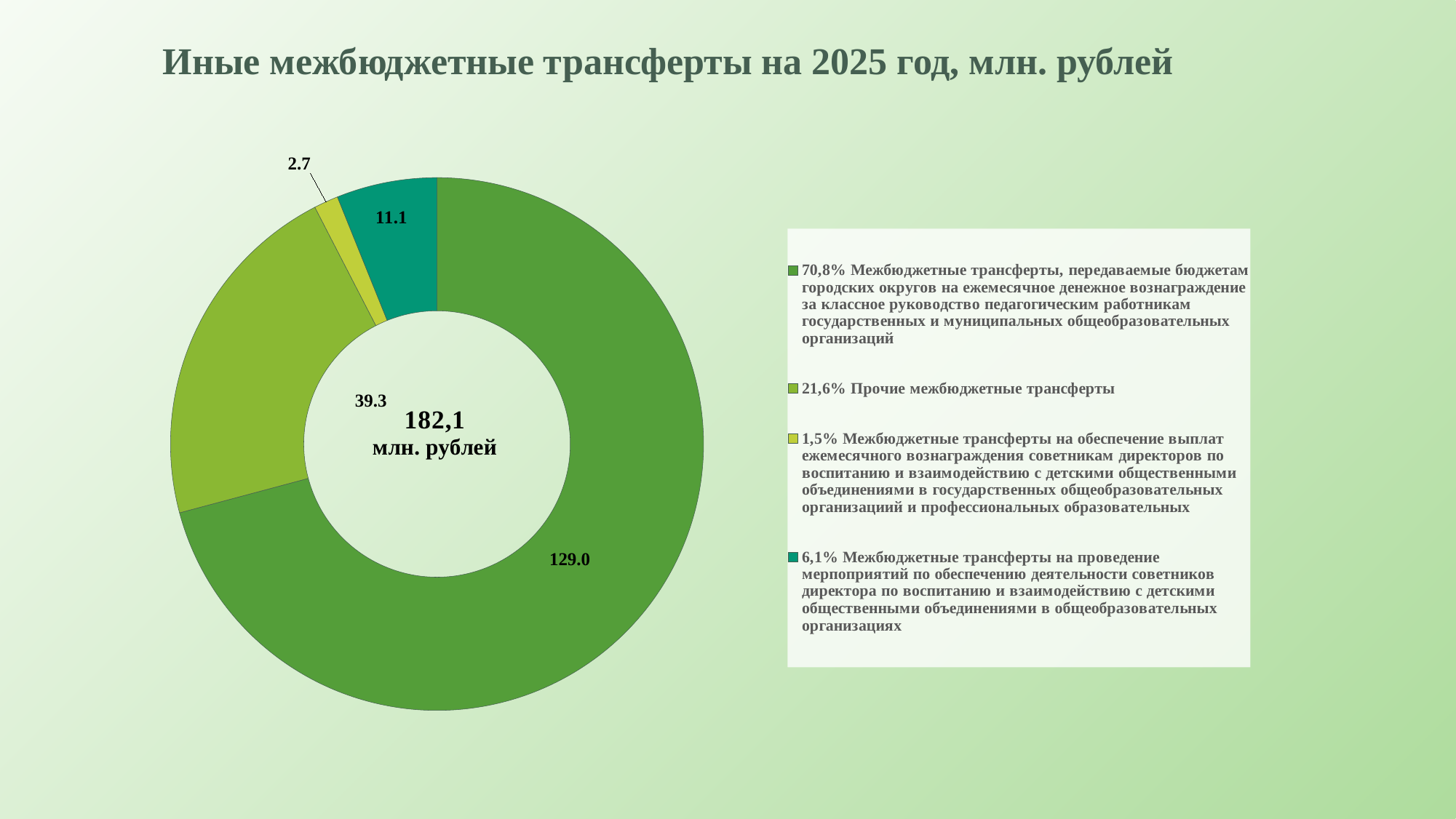
Which category has the smallest slice? Межбюджетные трансферты на обеспечение выплат ежемесячного вознаграждения советникам директоров (1,5%) How many slices does the doughnut chart have? 4 What is the value for the transfers for monthly remuneration for classroom leadership (классное руководство) to teachers? 129.0 Which is larger: the value for events supporting the director's advisor or the value for advisors' monthly remuneration? events supporting the director's advisor (11.1) What is the value for the transfers for holding events to support the activities of the director's advisor on upbringing? 11.1 What total is shown in the centre of the doughnut chart? 182,1 млн. рублей What kind of chart is shown on the slide? doughnut (pie) chart What share of the total do "Прочие межбюджетные трансферты" make up? 21,6% What is the value for "Прочие межбюджетные трансферты"? 39.3 Which category has the largest slice? Межбюджетные трансферты, передаваемые бюджетам городских округов на ежемесячное денежное вознаграждение за классное руководство (70,8%) What is the value for the transfers for monthly remuneration of advisors to directors (советникам директоров) on upbringing? 2.7 What is the difference between the value for classroom leadership transfers (129.0) and "Прочие межбюджетные трансферты" (39.3)? 89.7